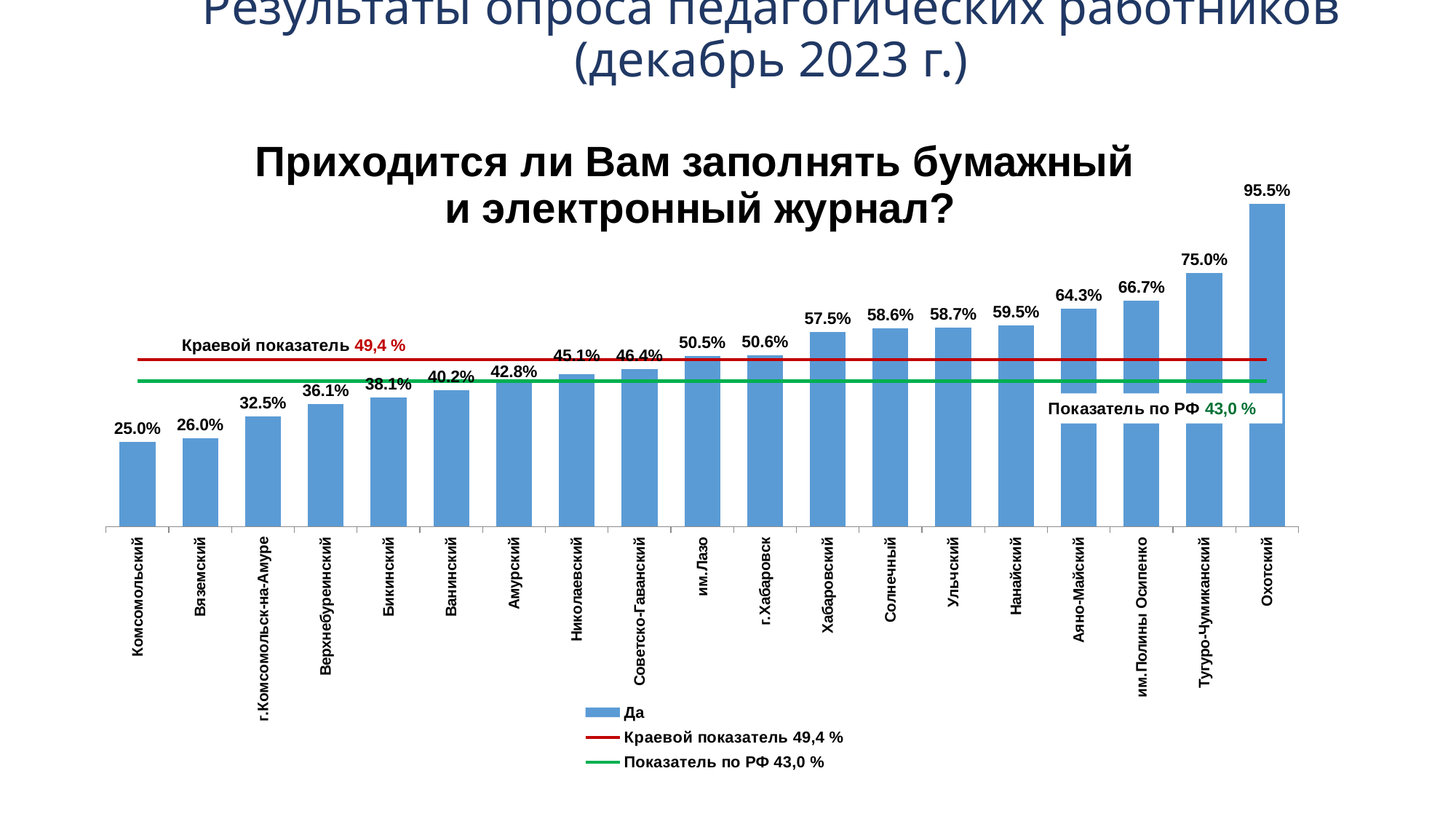
Which category has the highest value? Охотский What is the value for Ванинский? 40.2% What kind of chart is this? bar chart Which category has the lowest value? Комсомольский What is the value for Охотский? 95.5% Do the bar values rise or fall from left to right along the x axis? rise How many entries does the legend list? 3 Which is larger, the value for Бикинский or the value for Нанайский? Нанайский What is the difference between the values for Тугуро-Чумиканский and Аяно-Майский? 10.7% What value does the red horizontal line (Краевой показатель) represent? 49,4 % How many categories are shown on the x axis? 19 What is the value for г.Хабаровск? 50.6%